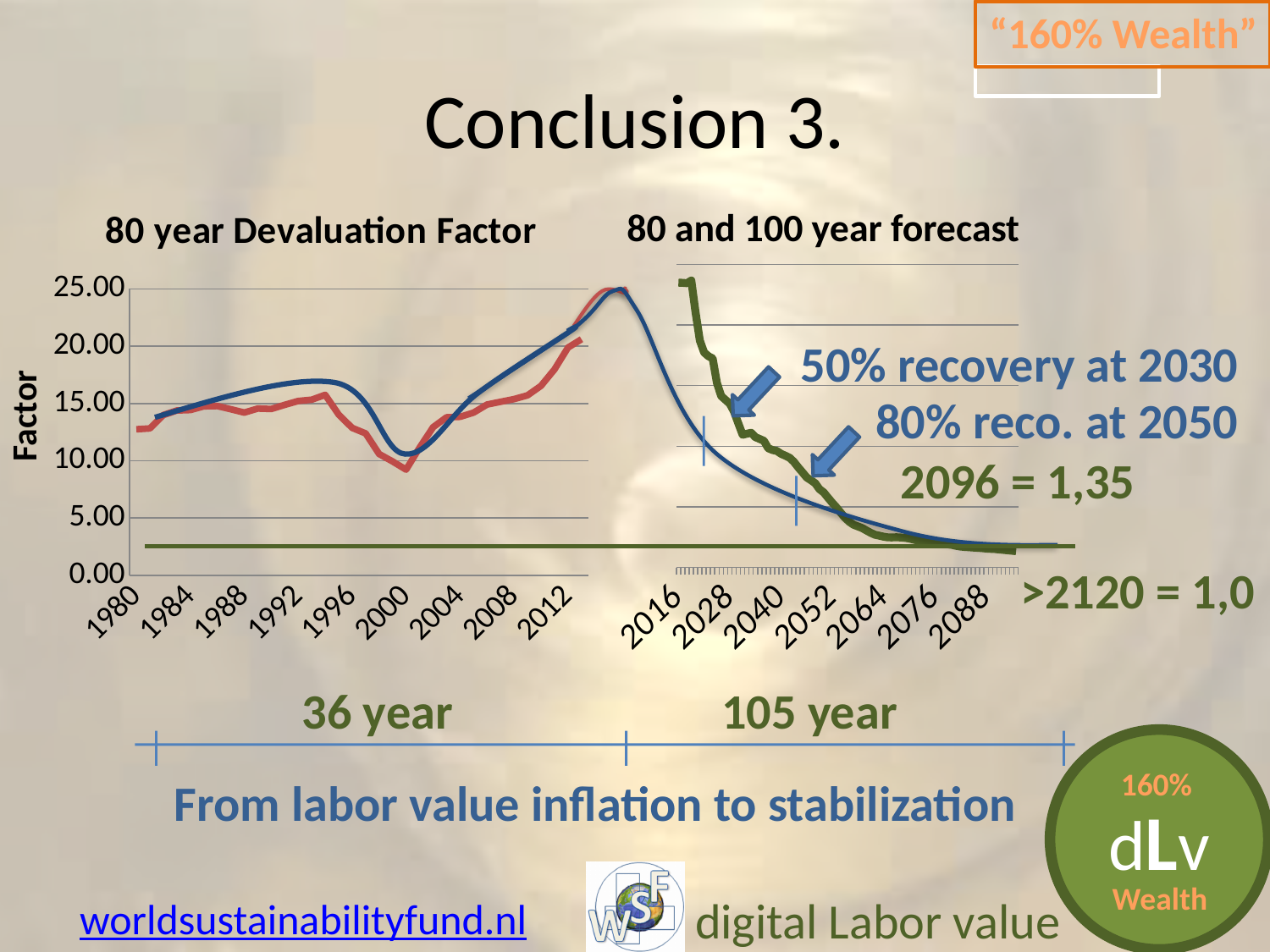
On the '80 year Devaluation Factor' chart, is the value for 1980 greater or less than 15.00? less On the '80 year Devaluation Factor' chart, what is the last year labelled on the x axis? 2012 On the '80 and 100 year forecast' chart, is the value for 2088 greater or less than 5.00? less What kind of chart is the '80 year Devaluation Factor' chart? line chart On the '80 year Devaluation Factor' chart, what is the highest value shown on the y axis? 25.00 On the '80 year Devaluation Factor' chart, what is the first year labelled on the x axis? 1980 On the '80 and 100 year forecast' chart, do the values rise or fall from 2016 to 2088? fall How many year labels are shown on the x axis of the '80 and 100 year forecast' chart? 7 On the '80 year Devaluation Factor' chart, do the values overall rise or fall from 1980 to 2012? rise What is the y-axis label on the '80 year Devaluation Factor' chart? Factor According to the annotation on the '80 and 100 year forecast' chart, what is the factor value in 2096? 1,35 On the '80 year Devaluation Factor' chart, is the value for 2012 greater or less than 15.00? greater